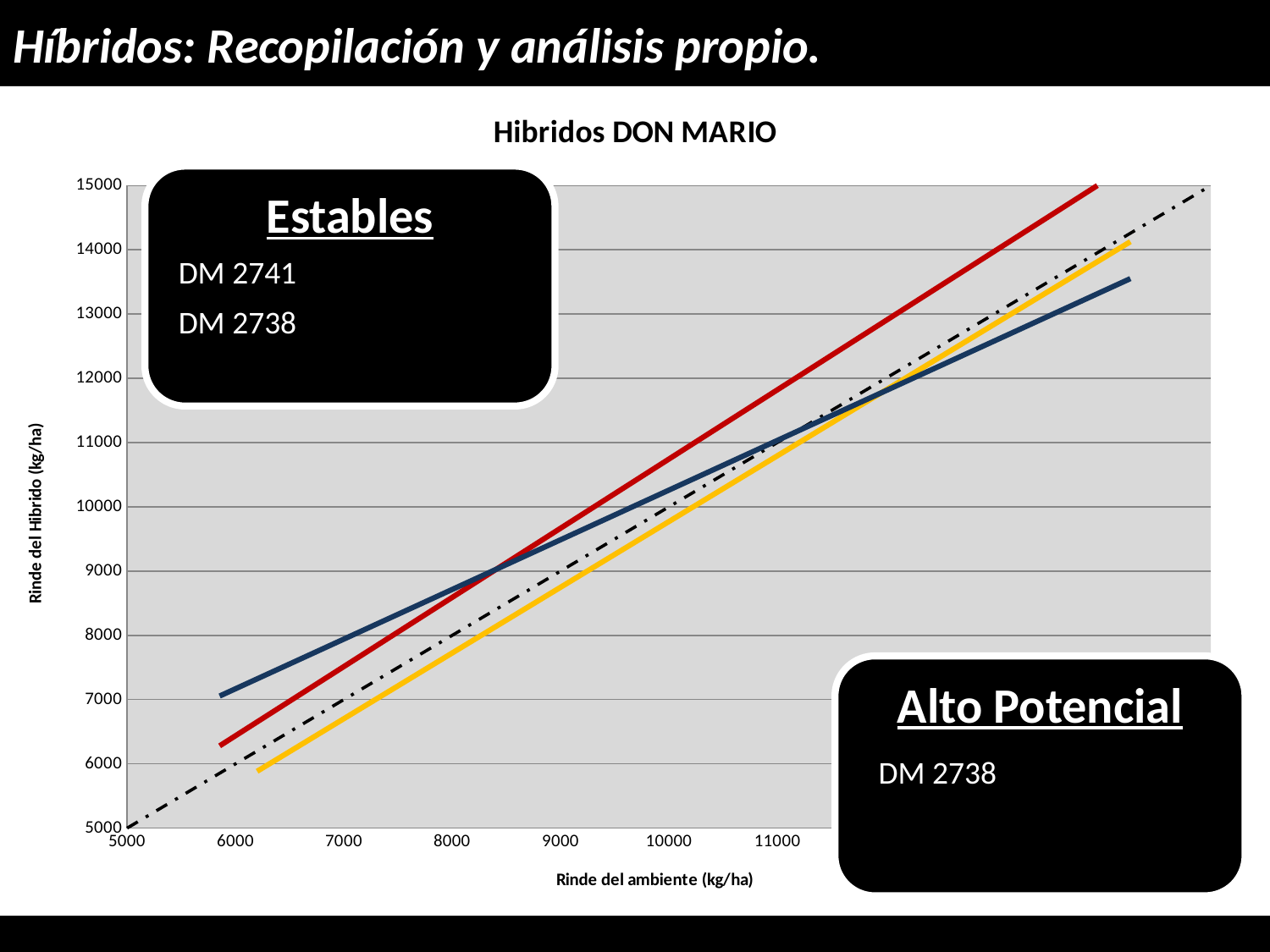
Which coloured line starts at the lowest value on the left side of the chart? the yellow line Which coloured line reaches the highest value on the chart? the red line At an x value of 7000, which line is higher, the blue line or the yellow line? the blue line At an x value of 13000, which line is higher, the red line or the blue line? the red line Is the value of the red line at an x value of 8000 greater or less than 8000? greater What kind of chart is shown on the slide? line chart What is the title of the chart? Hibridos DON MARIO How many solid coloured lines are plotted on the chart (excluding the dashed line)? 3 Is the value of the blue line at an x value of 13000 greater or less than 13000? less Is the value of the red line at an x value of 12000 greater or less than 12000? greater Do the plotted lines rise or fall as the value on the x axis increases? rise What is the label of the horizontal axis of the chart? Rinde del ambiente (kg/ha)